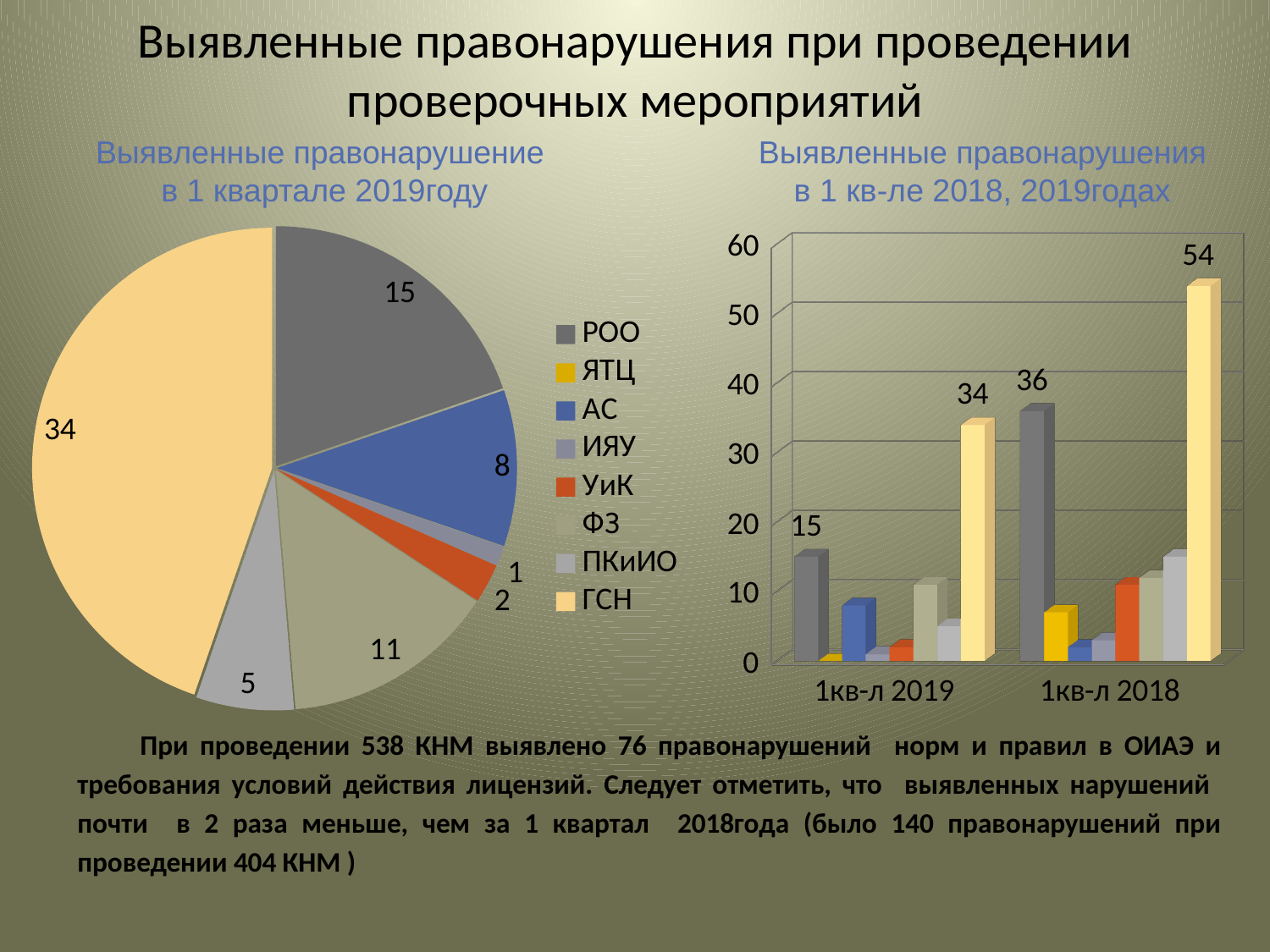
In the bar chart on the right, what is the difference between the ГСН values for 1кв-л 2018 and 1кв-л 2019? 20 In the bar chart on the right, is the value for АС in 1кв-л 2019 greater or less than 10? less In the pie chart on the left, which category has the largest slice? ГСН In the pie chart on the left, what is the value for ГСН? 34 In the pie chart on the left, which is larger, the value for АС or the value for ФЗ? ФЗ What kind of chart is the chart on the left? pie chart How many categories are shown on the x axis of the bar chart on the right? 2 In the bar chart on the right, what is the value for РОО in 1кв-л 2019? 15 In the pie chart on the left, what is the value for РОО? 15 In the pie chart on the left, what is the difference between the values for ГСН and РОО? 19 In the bar chart on the right, what is the value for ГСН in 1кв-л 2018? 54 How many entries does the legend of the pie chart on the left list? 8